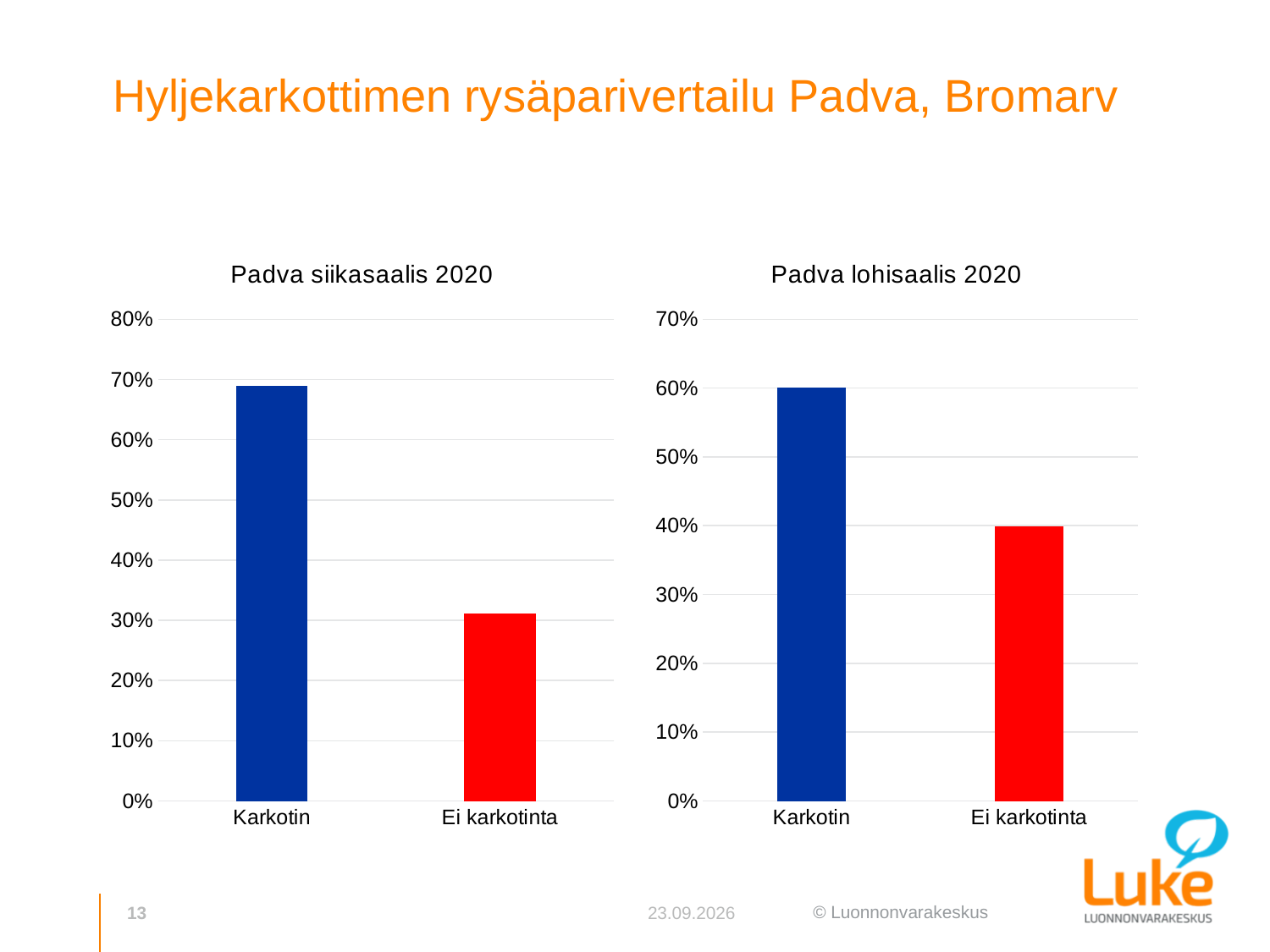
In the 'Padva siikasaalis 2020' chart, is the value for Karkotin greater or less than 60%? greater In the 'Padva lohisaalis 2020' chart, what colour is the Ei karkotinta bar? Red How many categories are shown in the 'Padva lohisaalis 2020' chart? 2 In the 'Padva lohisaalis 2020' chart, what is the difference between Karkotin and Ei karkotinta? 20% In the 'Padva lohisaalis 2020' chart, what is the value for Karkotin? 60% What is the title of the chart on the right side of the slide? Padva lohisaalis 2020 In the 'Padva lohisaalis 2020' chart, which category has the lowest value? Ei karkotinta In the 'Padva lohisaalis 2020' chart, what is the value for Ei karkotinta? 40% In the 'Padva siikasaalis 2020' chart, is the value for Ei karkotinta greater or less than 40%? less What kind of chart is the 'Padva siikasaalis 2020' chart? Bar chart In the 'Padva siikasaalis 2020' chart, which category has the highest value? Karkotin In the 'Padva siikasaalis 2020' chart, which is larger, Karkotin or Ei karkotinta? Karkotin